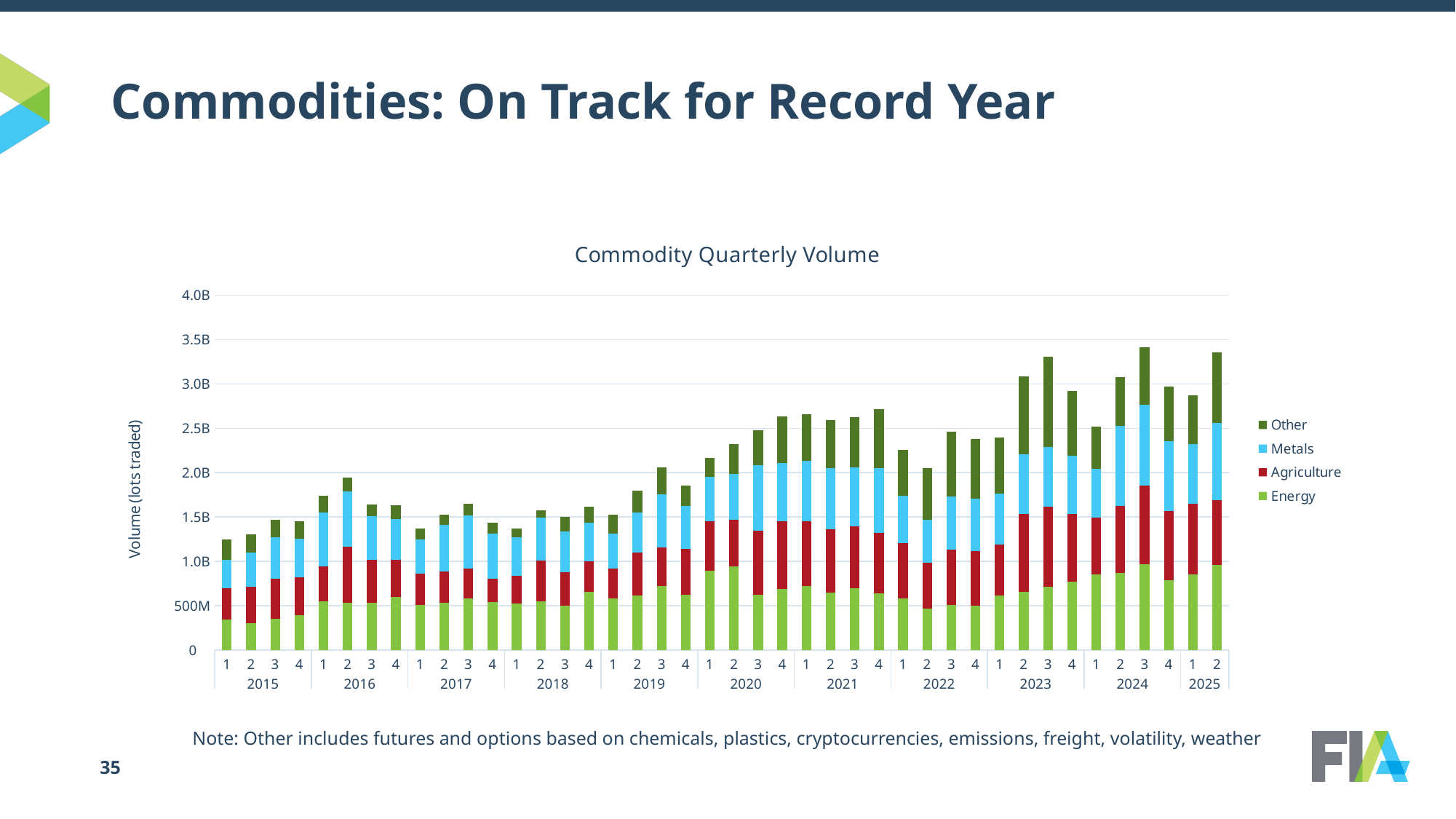
Which quarter has the larger total volume, Q2 2016 or Q1 2017? Q2 2016 How many quarterly bars are plotted in the Commodity Quarterly Volume chart? 42 Is the total volume for Q1 2018 greater or less than 1.5B? less What is the label on the vertical axis of the chart? Volume (lots traded) Is the total volume for Q1 2015 greater or less than 1.5B? less Which quarter has the larger total volume, Q3 2023 or Q2 2022? Q3 2023 What kind of chart is shown on the slide? Stacked bar chart How many series does the legend of the Commodity Quarterly Volume chart list? 4 Is the total volume for Q4 2020 greater or less than 2.5B? greater Overall, does total commodity quarterly volume rise or fall from 2015 to 2025? Rise